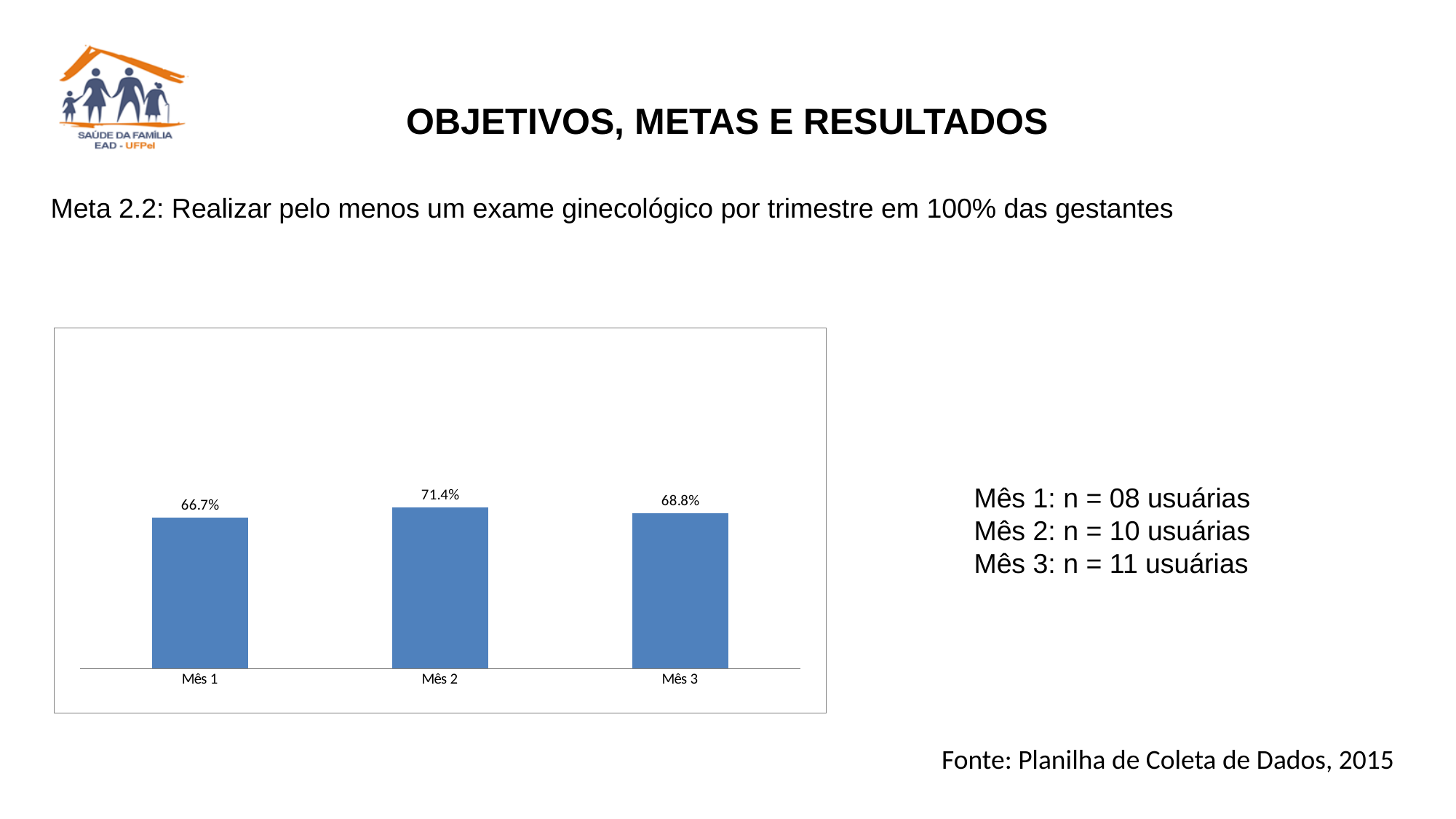
What is the value for Mês 1? 66.7% What kind of chart is shown on the slide? Bar chart What is the value for Mês 3? 68.8% What is the difference between the values for Mês 2 and Mês 1? 4.7% What is the value for Mês 2? 71.4% Which month has the lowest value? Mês 1 What is the difference between the values for Mês 2 and Mês 3? 2.6% Which month has the highest value? Mês 2 Does the value rise or fall from Mês 2 to Mês 3? Fall What colour are the bars in the chart? Blue How many categories are shown on the x axis? 3 Which is larger, the value for Mês 3 or the value for Mês 1? Mês 3